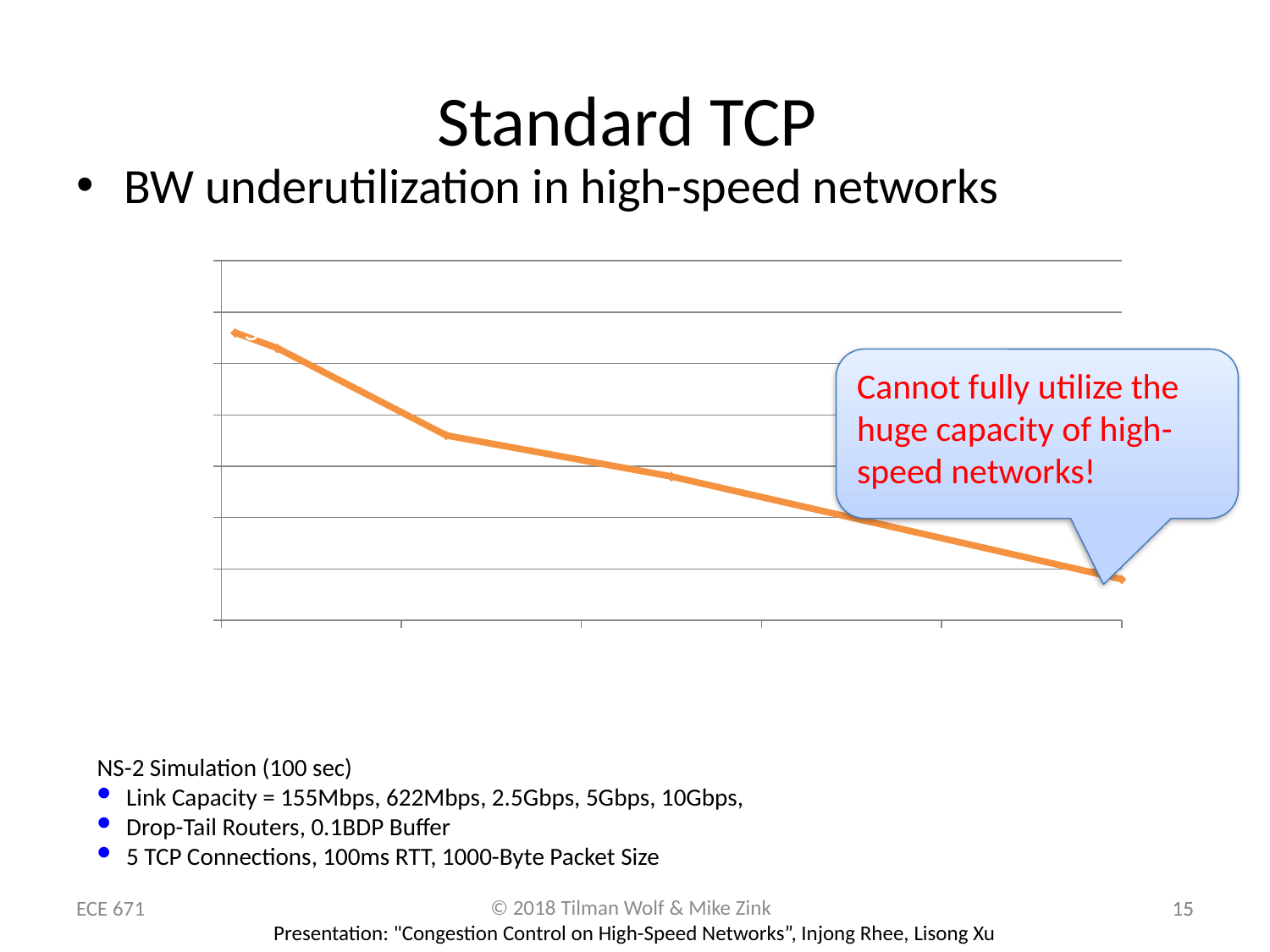
How many lines (series) are plotted on the chart? 1 What does the callout on the chart say? Cannot fully utilize the huge capacity of high-speed networks! Do the plotted values rise or fall from left to right along the x axis? fall What colour is the plotted line? orange How many data points are plotted on the line? 5 Which is higher, the leftmost point or the rightmost point on the line? the leftmost point What kind of chart is shown on the slide? line chart